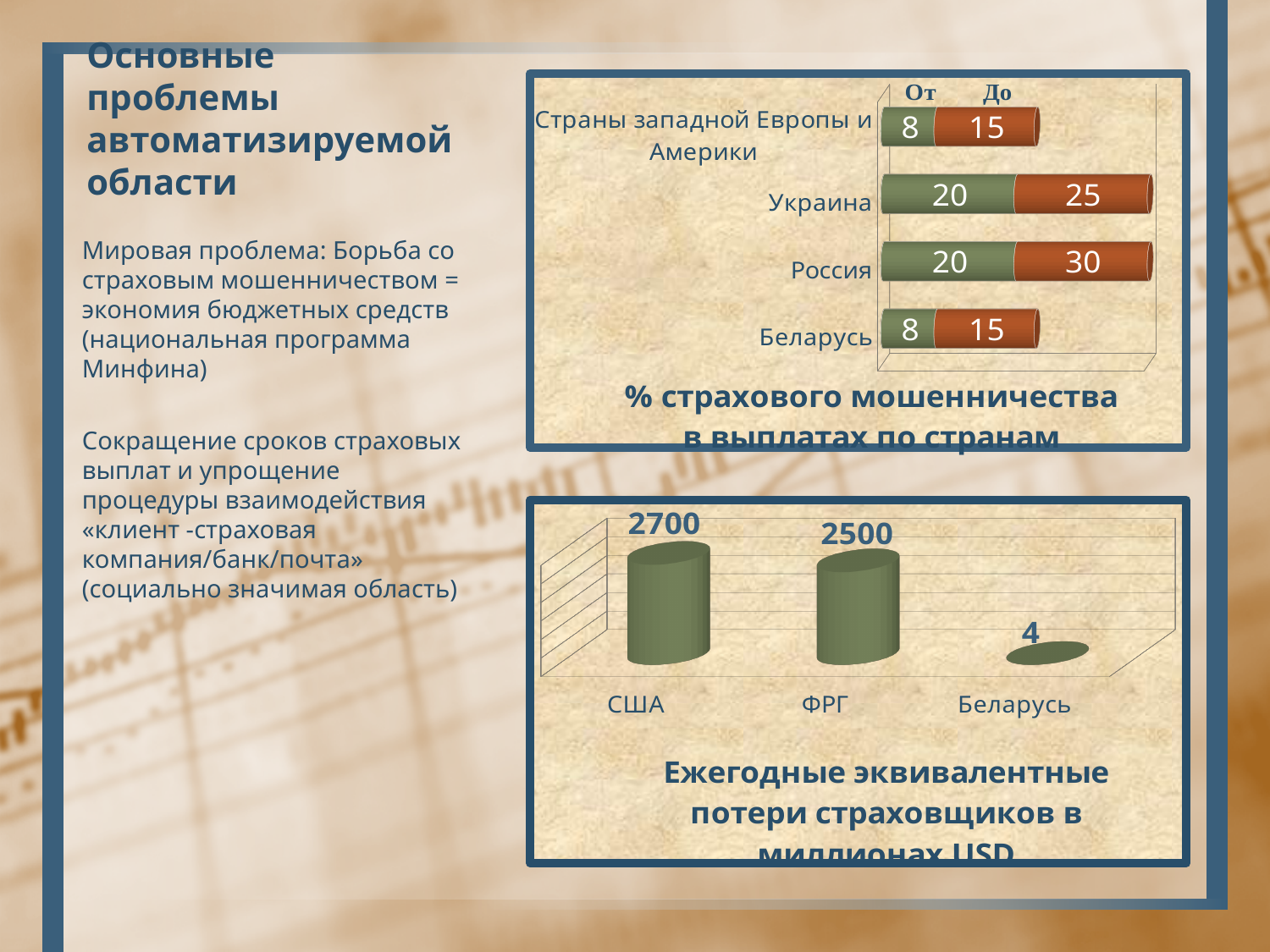
In the bottom chart (Ежегодные эквивалентные потери страховщиков в миллионах USD), what is the value for Беларусь? 4 In the top chart (% страхового мошенничества в выплатах по странам), what is the difference between the 'До' values for Россия and Украина? 5 In the top chart (% страхового мошенничества в выплатах по странам), which country has the highest 'До' value? Россия In the top chart (% страхового мошенничества в выплатах по странам), what is the 'От' value for Украина? 20 In the bottom chart (Ежегодные эквивалентные потери страховщиков в миллионах USD), what kind of chart is it? Bar chart In the top chart (% страхового мошенничества в выплатах по странам), what is the 'До' value for Беларусь? 15 In the top chart (% страхового мошенничества в выплатах по странам), how many categories are shown? 4 In the top chart (% страхового мошенничества в выплатах по странам), what is the 'До' value for Россия? 30 In the bottom chart (Ежегодные эквивалентные потери страховщиков в миллионах USD), which category has the lowest value? Беларусь In the bottom chart (Ежегодные эквивалентные потери страховщиков в миллионах USD), what is the difference between the values for США and ФРГ? 200 In the bottom chart (Ежегодные эквивалентные потери страховщиков в миллионах USD), what is the value for США? 2700